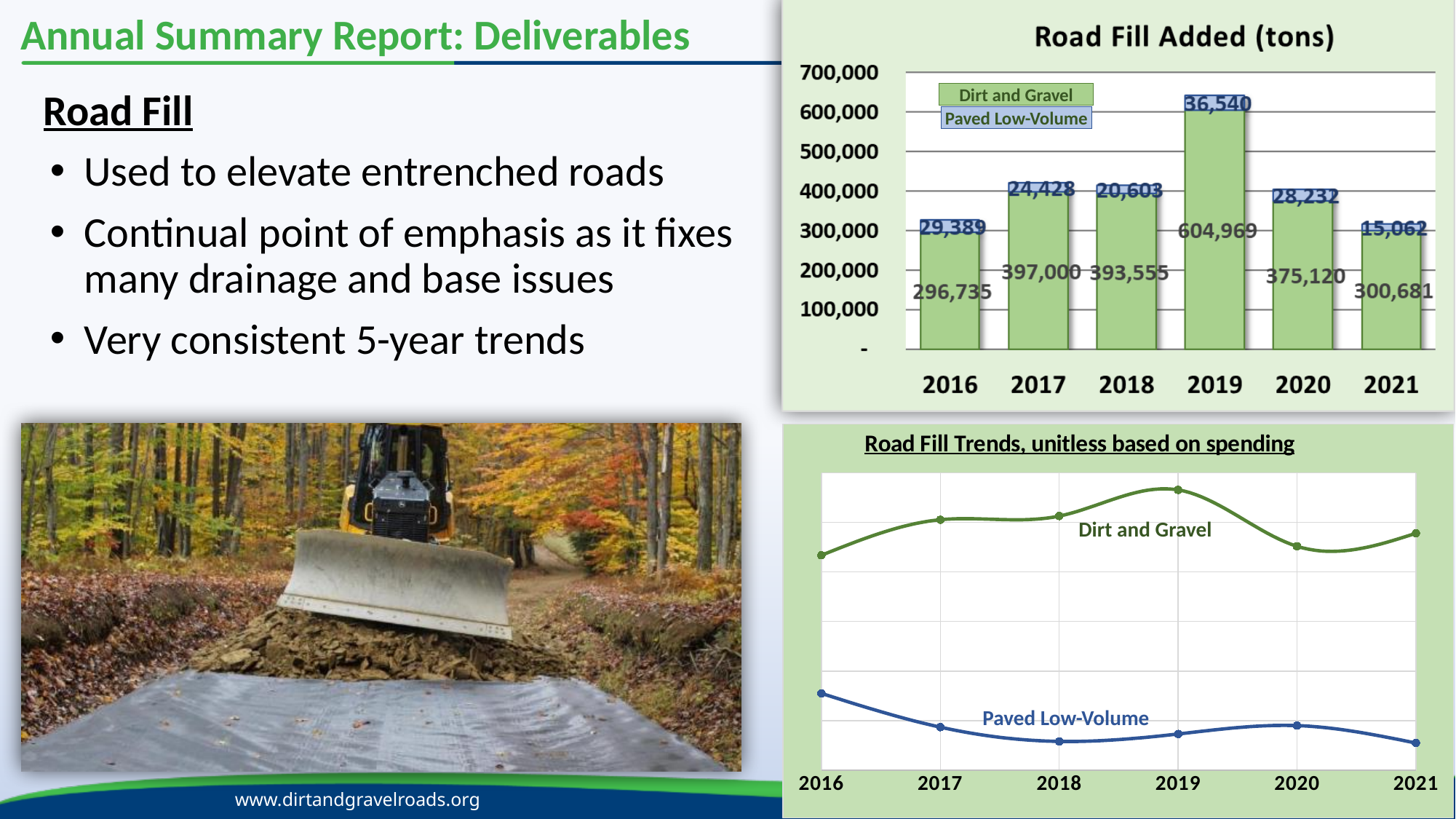
In the 'Road Fill Trends, unitless based on spending' chart, does the Paved Low-Volume line rise or fall from 2016 to 2017? Fall How many series does the legend of the 'Road Fill Added (tons)' chart list? 2 In the 'Road Fill Added (tons)' chart, which year has the lowest Dirt and Gravel value? 2016 How many years are shown on the x axis of the 'Road Fill Added (tons)' chart? 6 In the 'Road Fill Added (tons)' chart, what is the difference between the Dirt and Gravel values for 2019 and 2020? 229,849 In the 'Road Fill Added (tons)' chart, what is the total road fill added in 2016 (Dirt and Gravel plus Paved Low-Volume)? 326,124 In the 'Road Fill Added (tons)' chart, what is the Dirt and Gravel value for 2019? 604,969 What kind of chart is 'Road Fill Trends, unitless based on spending'? Line chart In the 'Road Fill Added (tons)' chart, which year has the highest Dirt and Gravel value? 2019 In the 'Road Fill Added (tons)' chart, what is the Paved Low-Volume value for 2021? 15,062 In the 'Road Fill Added (tons)' chart, which is larger: the Paved Low-Volume value for 2016 or for 2017? 2016 In the 'Road Fill Trends, unitless based on spending' chart, in which year does the Dirt and Gravel line reach its highest point? 2019